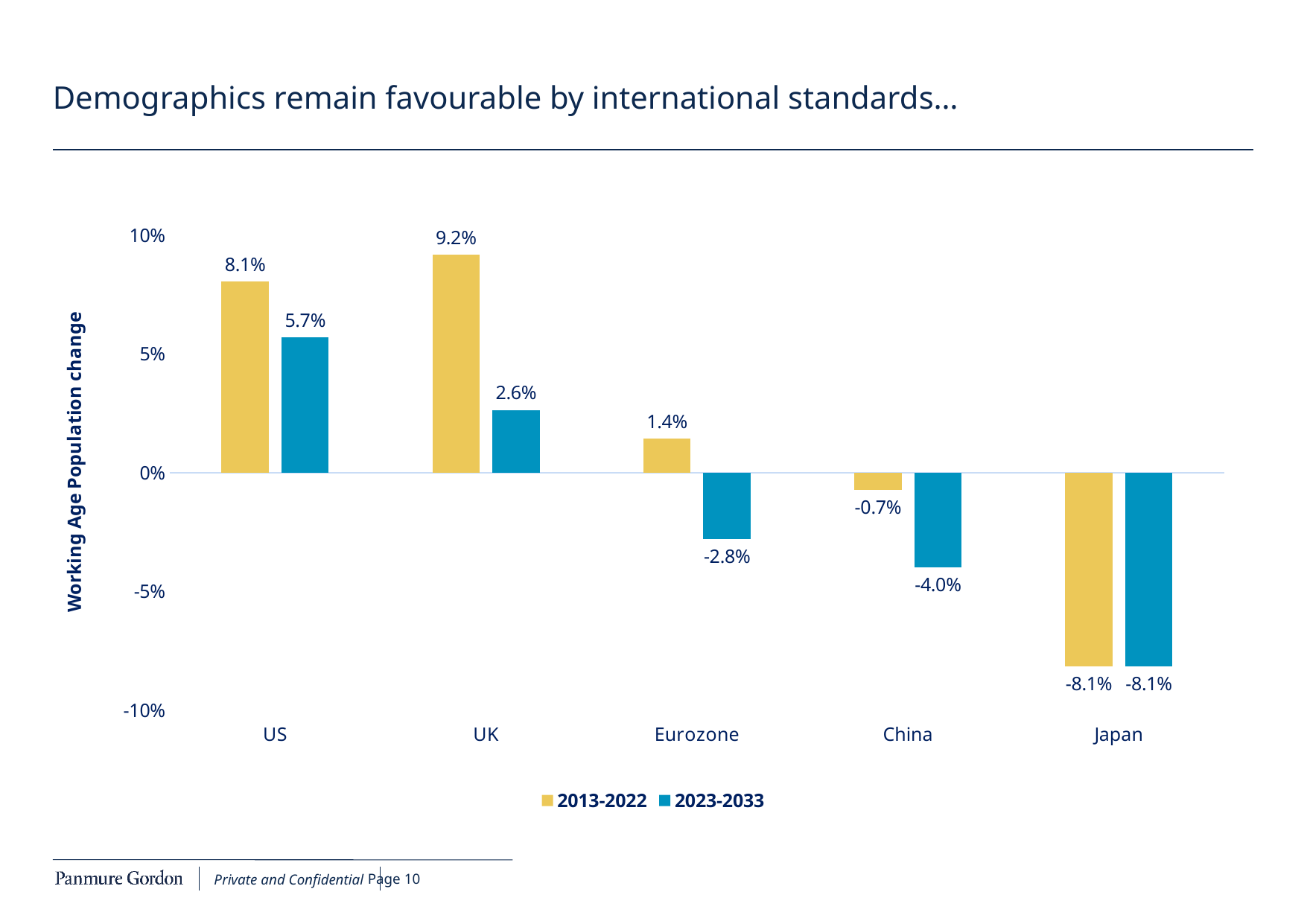
Which country has the highest 2013-2022 working age population change? UK What is the y-axis label of the chart? Working Age Population change What is the 2023-2033 working age population change for the UK? 2.6% Is the 2013-2022 value for the UK greater or less than 5%? greater Which country has the lowest 2023-2033 working age population change? Japan How many series does the legend list? 2 What is the 2023-2033 value for China? -4.0% How many countries or regions are shown on the x axis? 5 What kind of chart is shown on the slide? Bar chart Which is larger for the Eurozone: the 2013-2022 value or the 2023-2033 value? 2013-2022 What is the difference between the US 2013-2022 and 2023-2033 values? 2.4% What is the 2013-2022 working age population change for the US? 8.1%